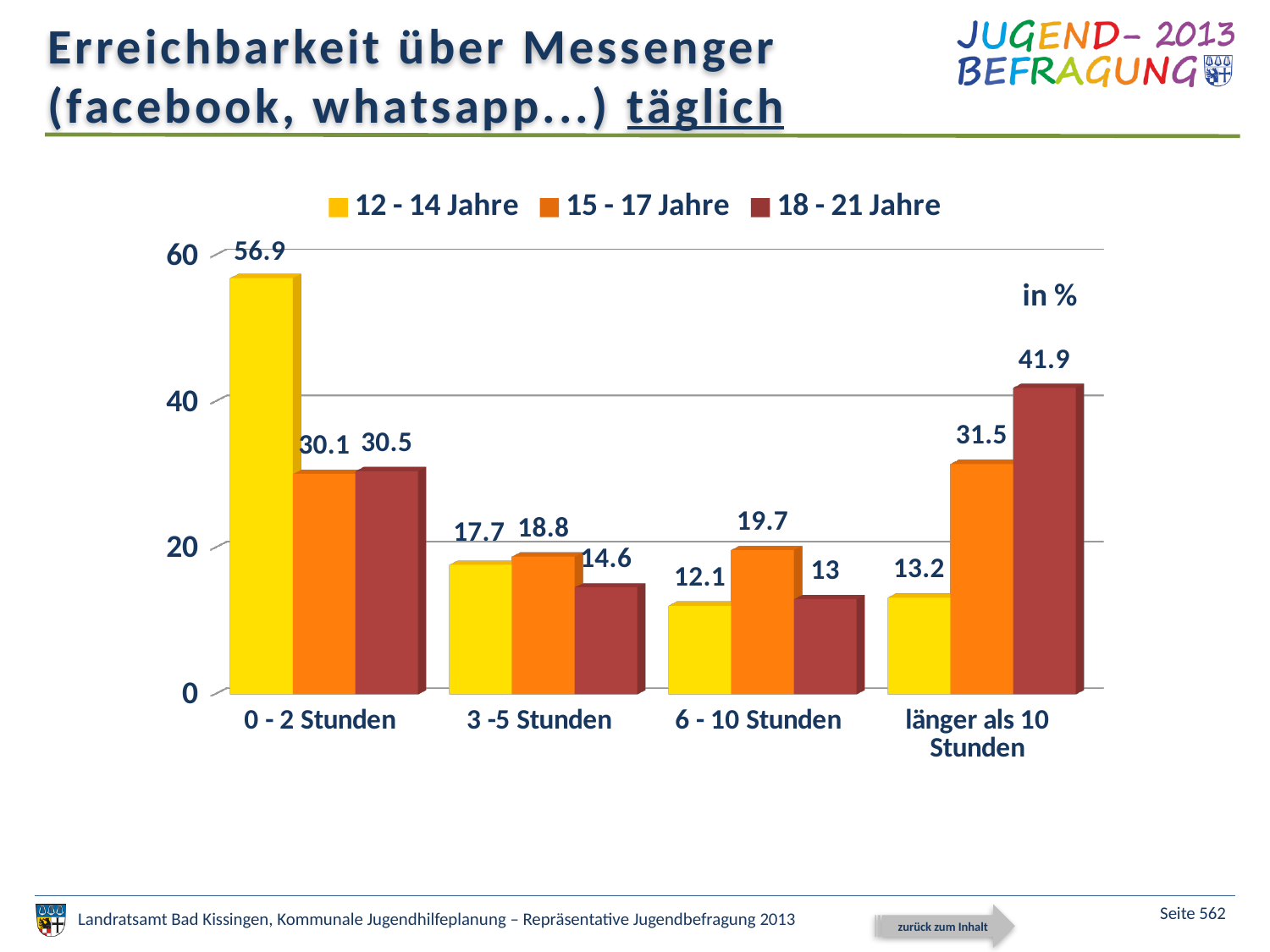
Which category has the highest value for the 12 - 14 Jahre series? 0 - 2 Stunden What kind of chart is shown on the slide? bar chart How many series does the legend list? 3 Which is larger in the 3 -5 Stunden category: the value for 15 - 17 Jahre or for 18 - 21 Jahre? 15 - 17 Jahre What is the value for 18 - 21 Jahre in the länger als 10 Stunden category? 41.9 What is the value for 12 - 14 Jahre in the 0 - 2 Stunden category? 56.9 What unit is indicated for the values in the chart? in % What is the difference between the 12 - 14 Jahre and 18 - 21 Jahre values in the 0 - 2 Stunden category? 26.4 Is the value for 15 - 17 Jahre in the länger als 10 Stunden category greater or less than 40? less How many categories are shown on the x axis? 4 What is the value for 15 - 17 Jahre in the 6 - 10 Stunden category? 19.7 Which category has the lowest value for the 18 - 21 Jahre series? 6 - 10 Stunden